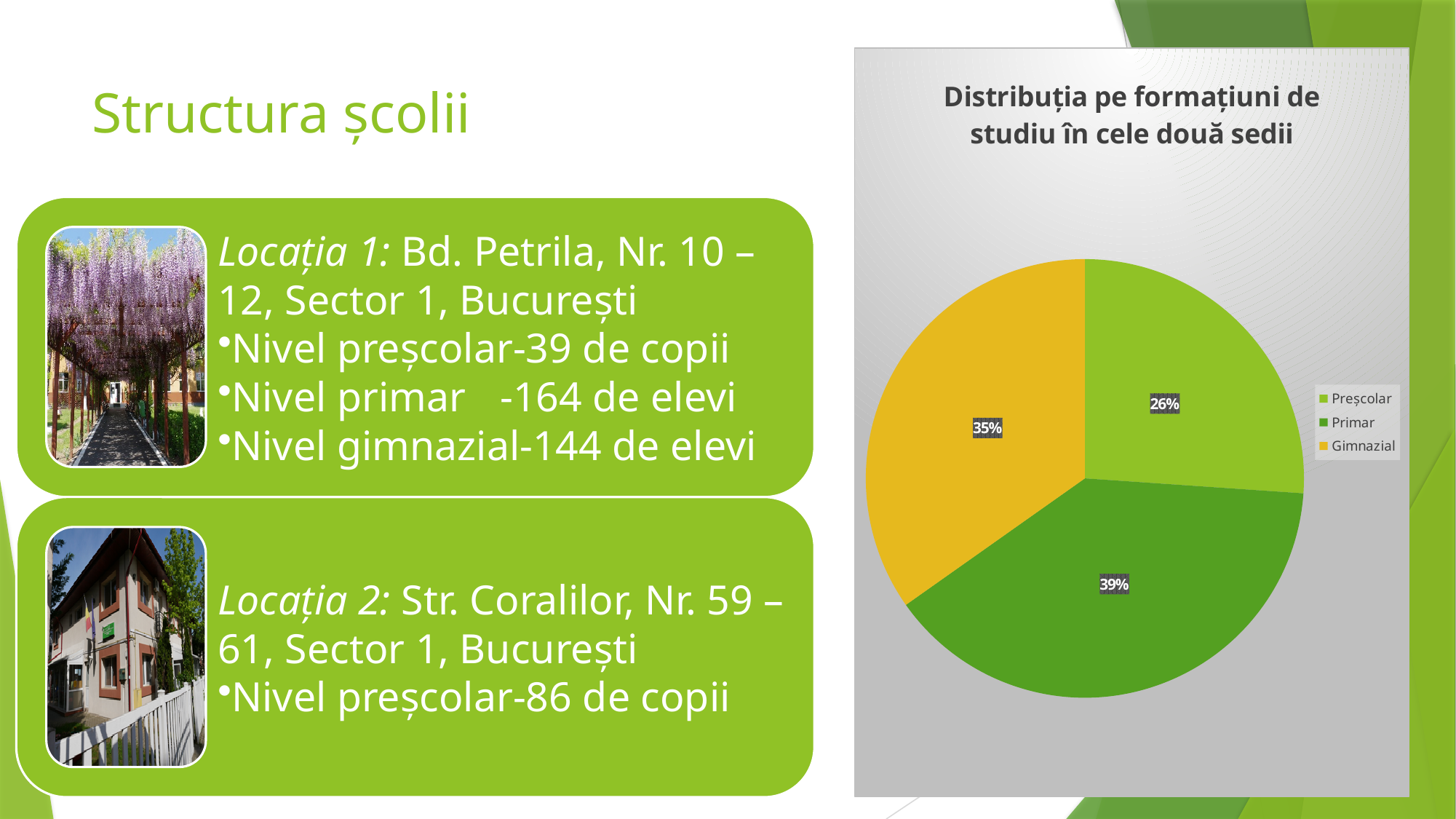
What is the title of the chart? Distribuția pe formațiuni de studiu în cele două sedii What is the difference in percentage points between Primar and Preșcolar? 13 What colour is the Gimnazial slice in the pie chart? yellow Which is larger, the share for Gimnazial or the share for Preșcolar? Gimnazial What percentage of the pie does Primar represent? 39% What percentage of the pie does Preșcolar represent? 26% How many entries does the legend list? 3 How many slices does the pie chart have? 3 Which category has the largest share of the pie? Primar Which category has the smallest share of the pie? Preșcolar What percentage of the pie does Gimnazial represent? 35% What kind of chart is shown on the slide? pie chart